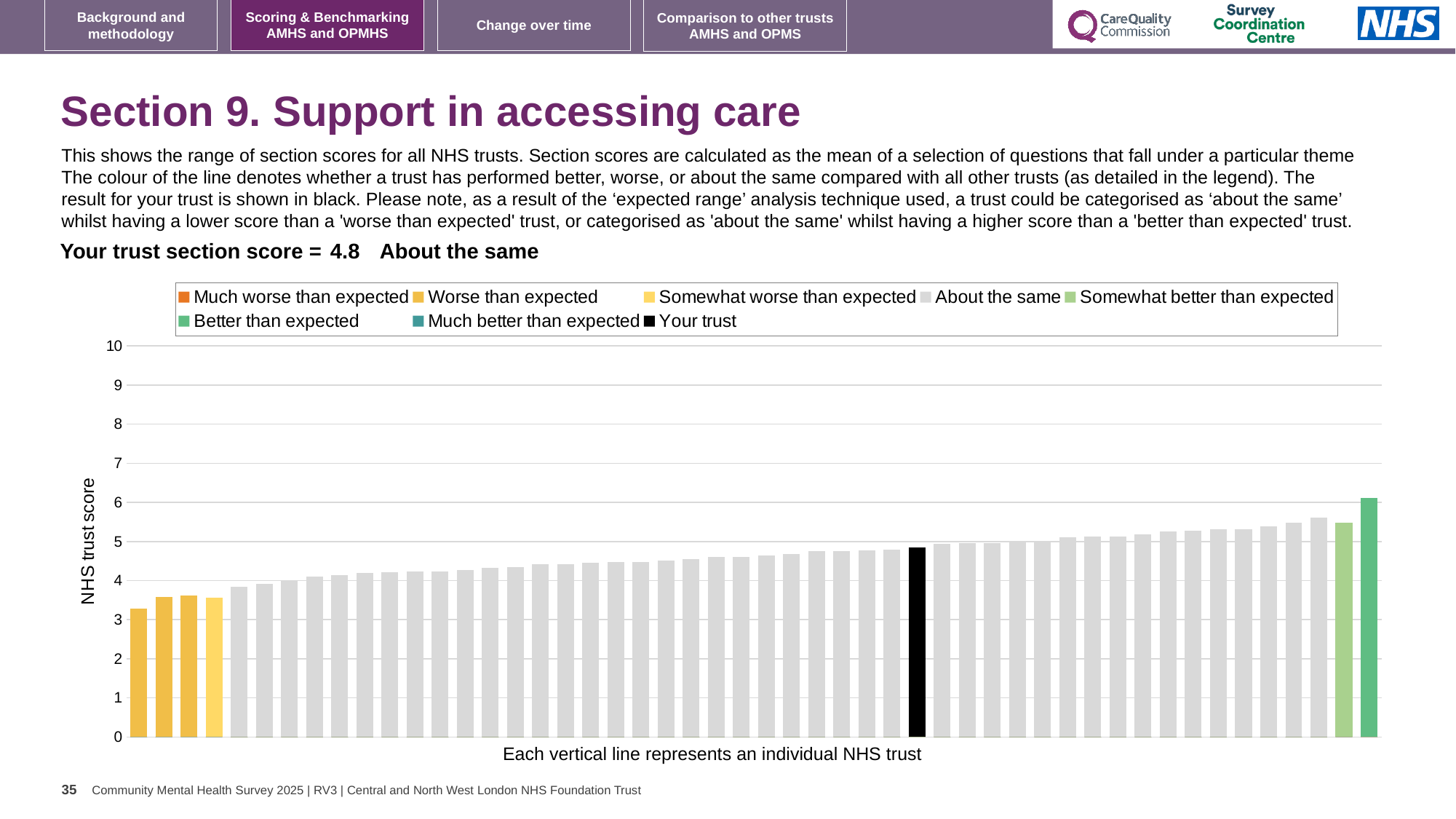
Which category does your trust fall into according to the slide? About the same Do the bar values rise or fall from left to right across the chart? rise Which bar is taller: the black 'Your trust' bar or the rightmost green bar? the rightmost green bar What is the label on the vertical axis of the chart? NHS trust score Is the value of the rightmost bar greater or less than 5? greater How many entries does the chart legend list? 8 What is the section score for your trust shown on the slide? 4.8 Is the value of the black 'Your trust' bar greater or less than 4? greater Is the value of the black 'Your trust' bar greater or less than 5? less What kind of chart is shown on the slide? bar chart What colour is the bar representing your trust? black